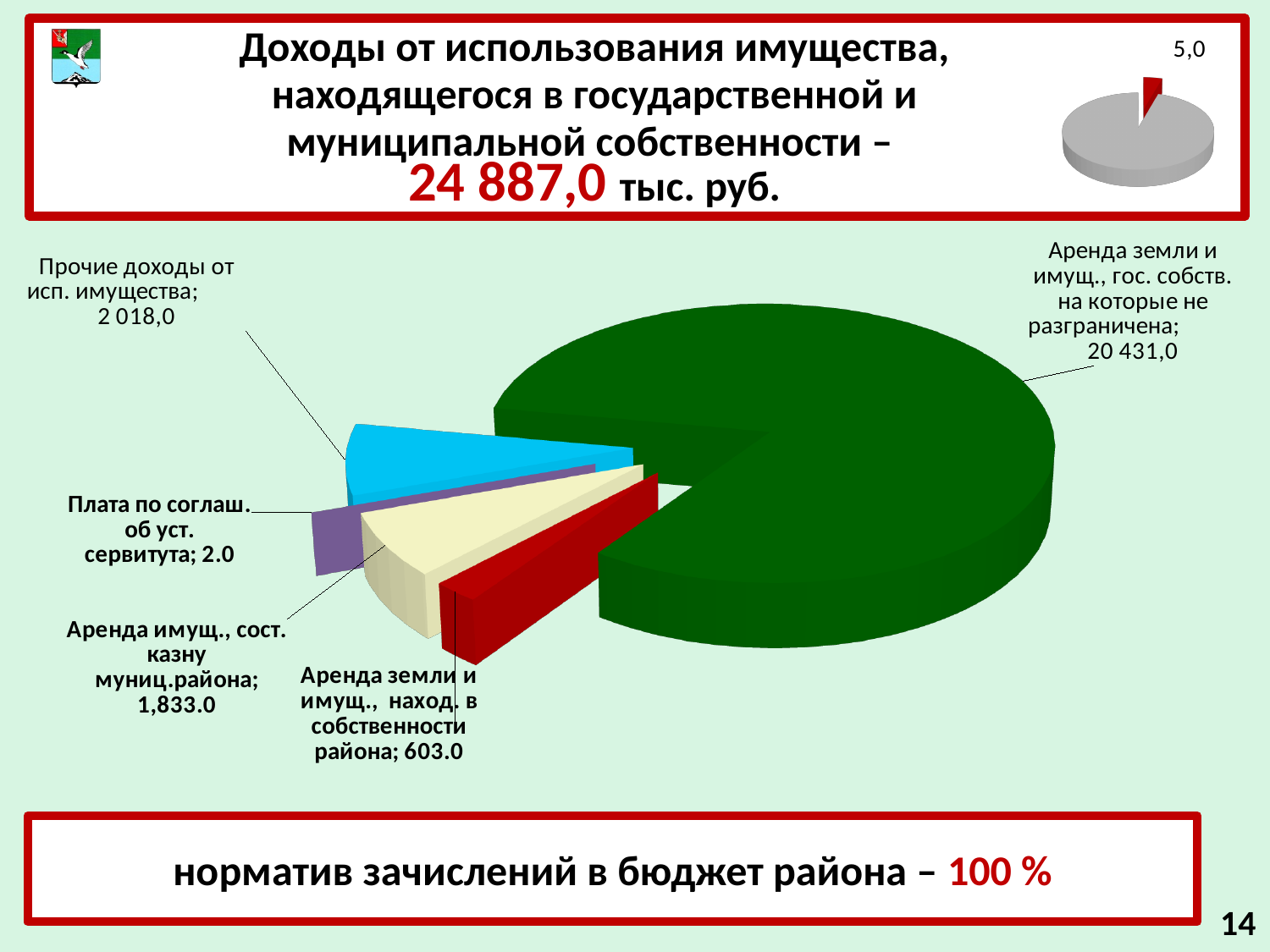
Which slice of the main pie chart is the largest? Аренда земли и имущ., гос. собств. на которые не разграничена What is the value for "Прочие доходы от исп. имущества" in the main pie chart? 2 018,0 What is the value for "Аренда земли и имущ., гос. собств. на которые не разграничена" in the main pie chart? 20 431,0 What total amount in тыс. руб. is stated in the slide title for the main pie chart? 24 887,0 What type of chart is shown on the slide? pie chart Which slice of the main pie chart is the smallest? Плата по соглаш. об уст. сервитута What is the value for "Плата по соглаш. об уст. сервитута" in the main pie chart? 2.0 What is the value for "Аренда земли и имущ., наход. в собственности района" in the main pie chart? 603.0 What is the value for "Аренда имущ., сост. казну муниц.района" in the main pie chart? 1,833.0 What is the difference between "Аренда земли и имущ., гос. собств. на которые не разграничена" (20 431,0) and "Прочие доходы от исп. имущества" (2 018,0) in the main pie chart? 18 413,0 How many slices does the main pie chart have? 5 In the main pie chart, which is larger: "Прочие доходы от исп. имущества" or "Аренда имущ., сост. казну муниц.района"? Прочие доходы от исп. имущества